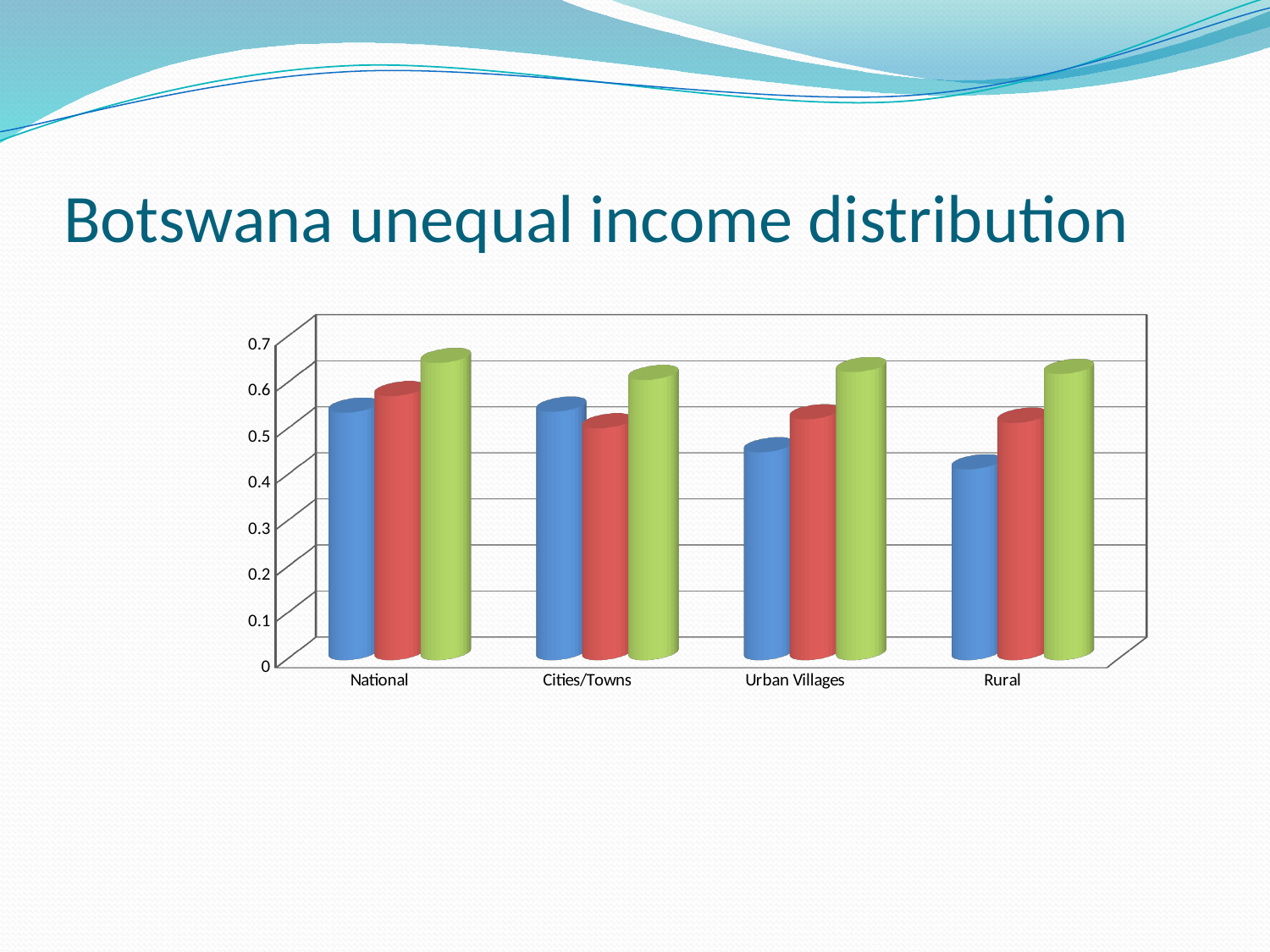
Is the value of the green bar for Rural greater or less than 0.5? greater Is the value of the green bar for National greater or less than 0.6? greater How many categories are shown on the x axis of the chart? 4 What is the title of the slide containing the chart? Botswana unequal income distribution Do the blue bars generally rise or fall from National to Rural along the x axis? fall Among the blue bars, which category has the lowest value? Rural For the Rural category, which is larger: the blue bar or the green bar? the green bar Is the value of the blue bar for Rural greater or less than 0.5? less What kind of chart is shown on the slide? bar chart Which colour of bar is the tallest in every category of the chart? green How many bars are plotted for each category in the chart? 3